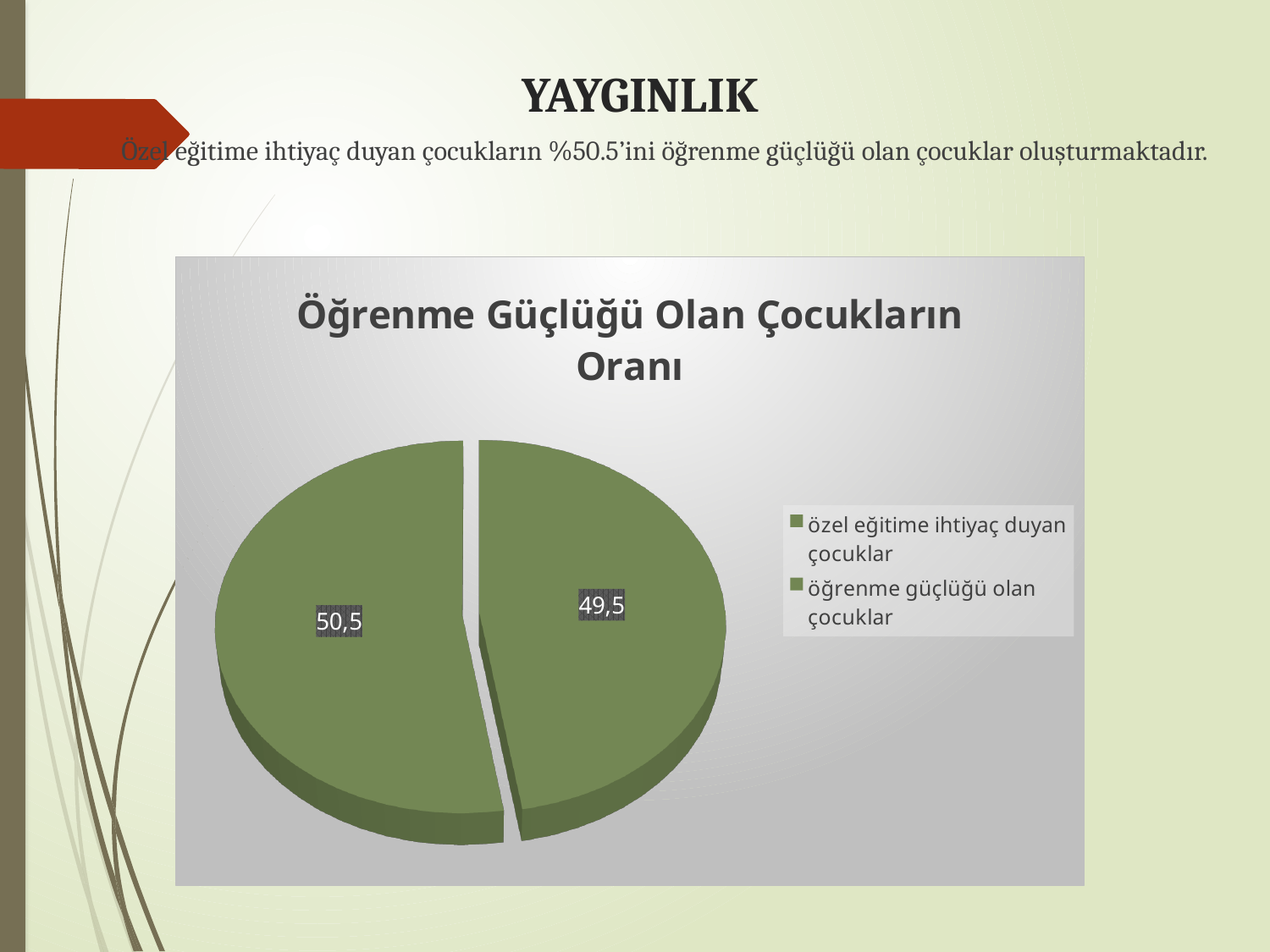
How many slices does the pie chart have? 2 What do the two slice values in the pie chart add up to? 100 What is the value of the smallest slice in the pie chart? 49,5 What kind of chart is shown on the slide? pie chart What value is printed on the right slice of the pie chart? 49,5 What is the difference between the two slice values in the pie chart? 1 How many entries does the chart legend list? 2 What are the two entries listed in the chart legend? özel eğitime ihtiyaç duyan çocuklar; öğrenme güçlüğü olan çocuklar What is the value of the largest slice in the pie chart? 50,5 What is the title of the chart? Öğrenme Güçlüğü Olan Çocukların Oranı What value is printed on the left slice of the pie chart? 50,5 Which slice is larger, the left slice or the right slice? the left slice